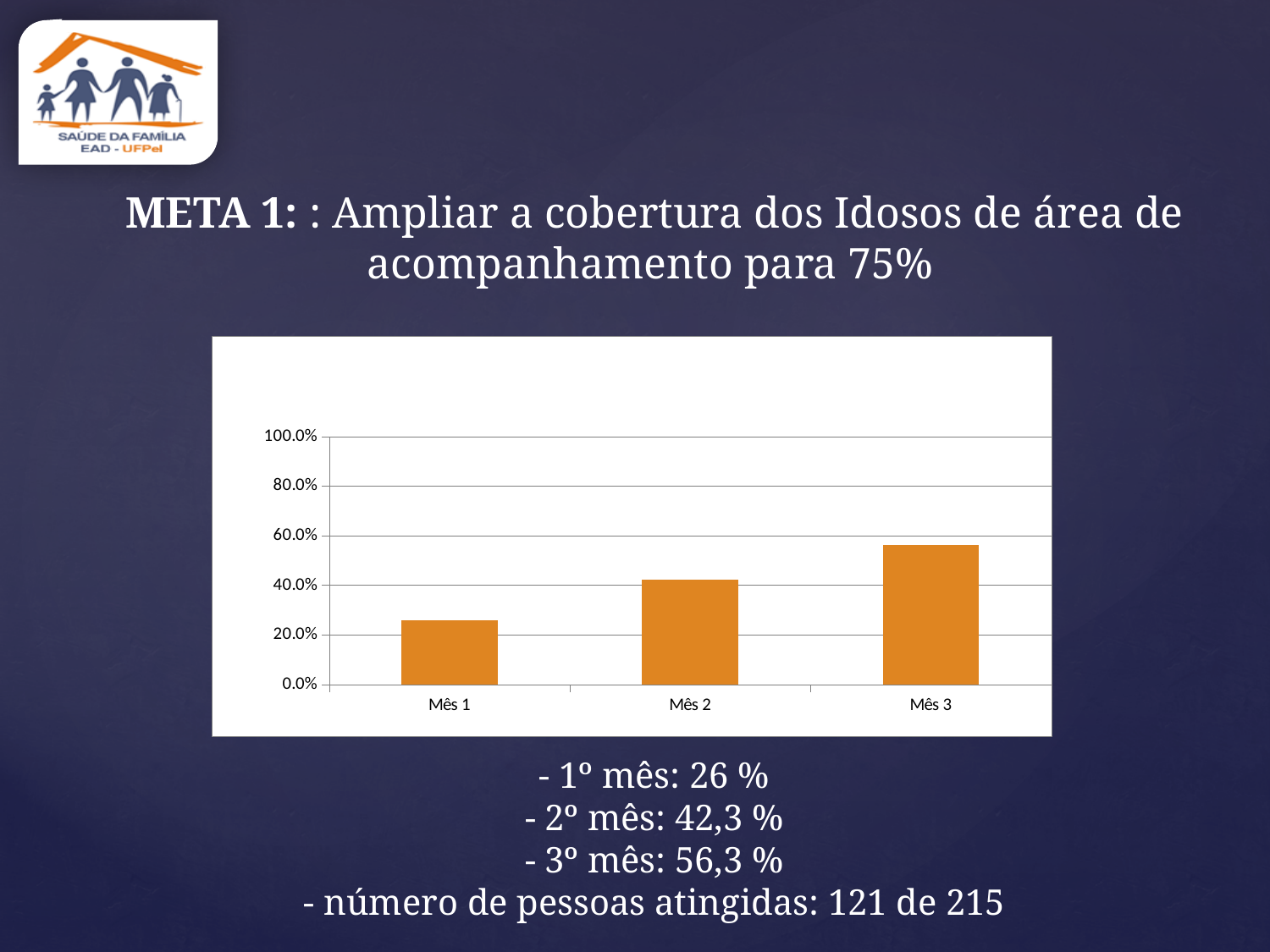
According to the text below the chart, what is the coverage value for the 1º mês? 26 % Which month has the highest bar on the chart? Mês 3 Is the value for Mês 1 greater or less than 20.0%? greater Do the values rise or fall from Mês 1 to Mês 3? rise Which is larger, the value for Mês 2 or the value for Mês 1? Mês 2 Is the value for Mês 2 greater or less than 60.0%? less What kind of chart is shown on the slide? bar chart Is the value for Mês 3 greater or less than 60.0%? less According to the text below the chart, what is the coverage value for the 3º mês? 56,3 % How many categories (months) are plotted on the chart? 3 What colour are the bars in the chart? orange Which month has the lowest bar on the chart? Mês 1